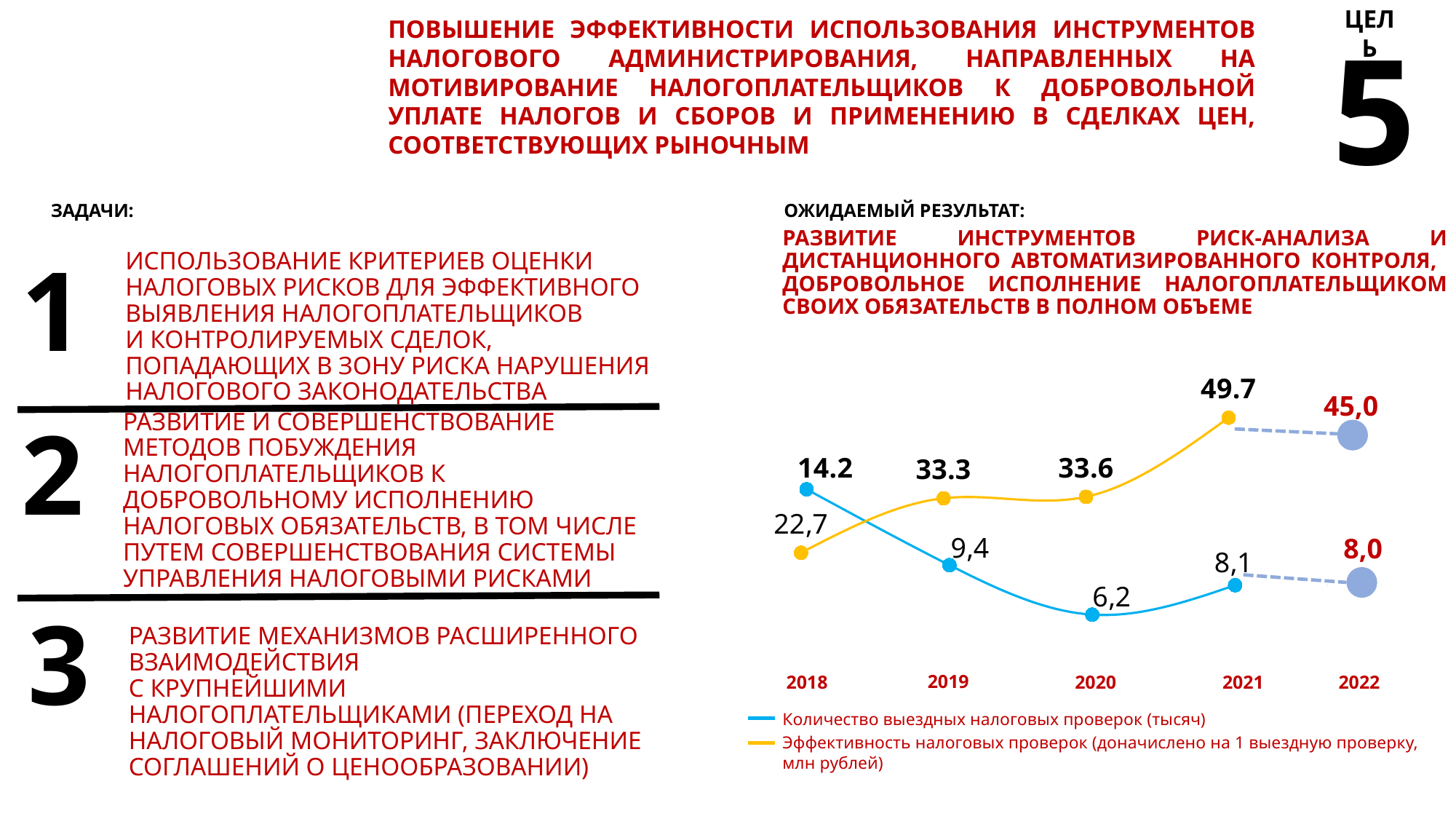
What is the difference between the 'Эффективность налоговых проверок' values for 2021 and 2020? 16.1 How many years are shown on the x axis of the chart? 5 In which year is 'Количество выездных налоговых проверок (тысяч)' lowest? 2020 Which is larger: 'Количество выездных налоговых проверок (тысяч)' in 2019 or in 2021? 2019 How many series does the chart legend list? 2 Does 'Количество выездных налоговых проверок (тысяч)' rise or fall from 2018 to 2020? fall What kind of chart is shown on the slide? line chart What is the value of 'Эффективность налоговых проверок' in 2021? 49.7 What is the value of 'Количество выездных налоговых проверок (тысяч)' in 2020? 6,2 What is the value of 'Эффективность налоговых проверок' in 2022? 45,0 What is the value of 'Количество выездных налоговых проверок (тысяч)' in 2018? 14.2 In which year is 'Эффективность налоговых проверок' highest? 2021